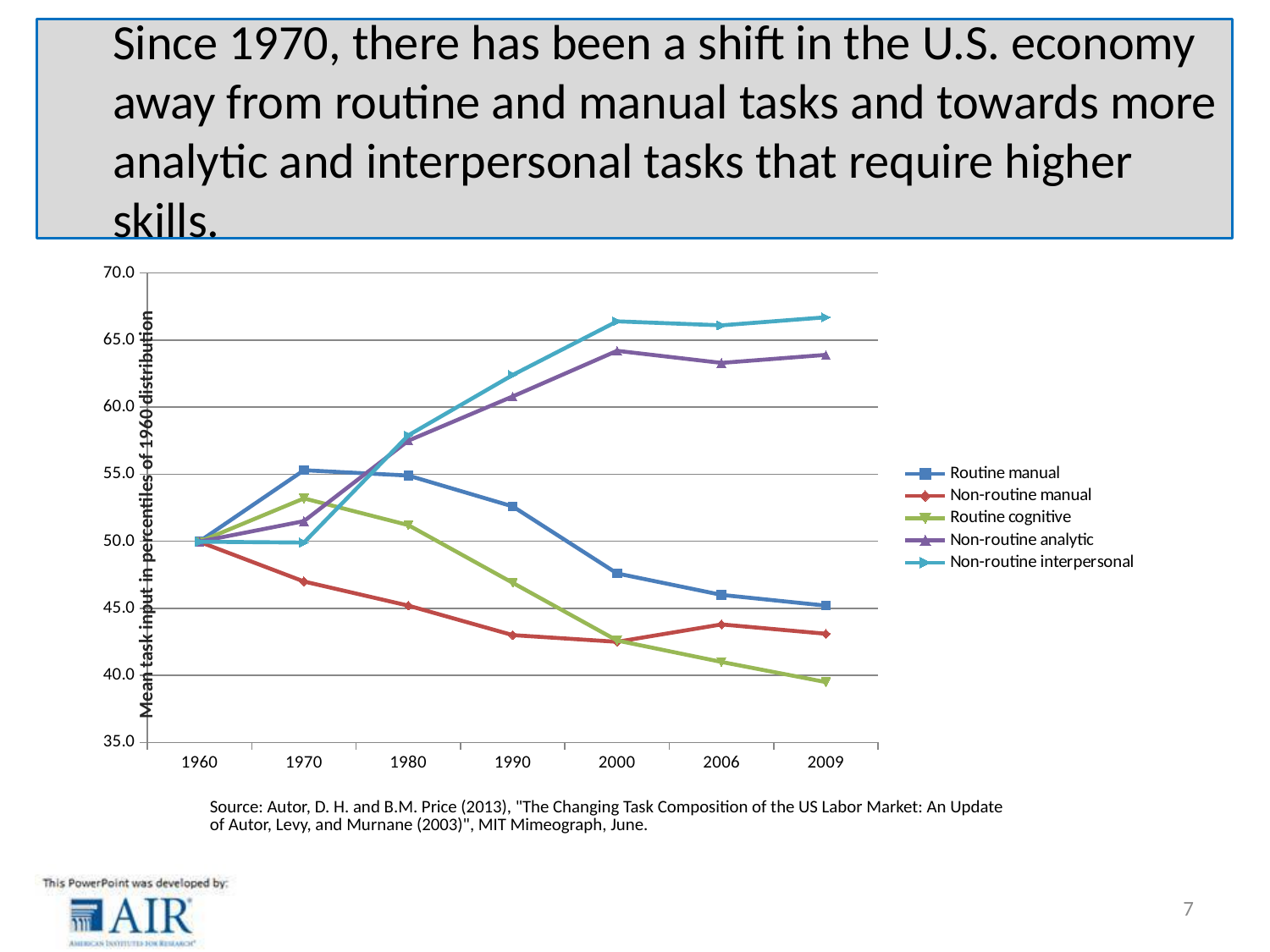
How many years are shown along the x axis? 7 Does the Routine cognitive series rise or fall from 1970 to 2009? Fall What is the label on the y axis? Mean task input in percentiles of 1960 distribution What kind of chart is shown on the slide? Line chart How many series does the legend list? 5 Is the value for Non-routine interpersonal in 2009 greater or less than 65.0? greater Is the value for Non-routine analytic in 2000 greater or less than 60.0? greater In 1980, which is larger: Routine manual or Non-routine manual? Routine manual Which series has the highest value in 2009? Non-routine interpersonal Which series has the lowest value in 2009? Routine cognitive Is the value for Non-routine manual in 1990 greater or less than 45.0? less